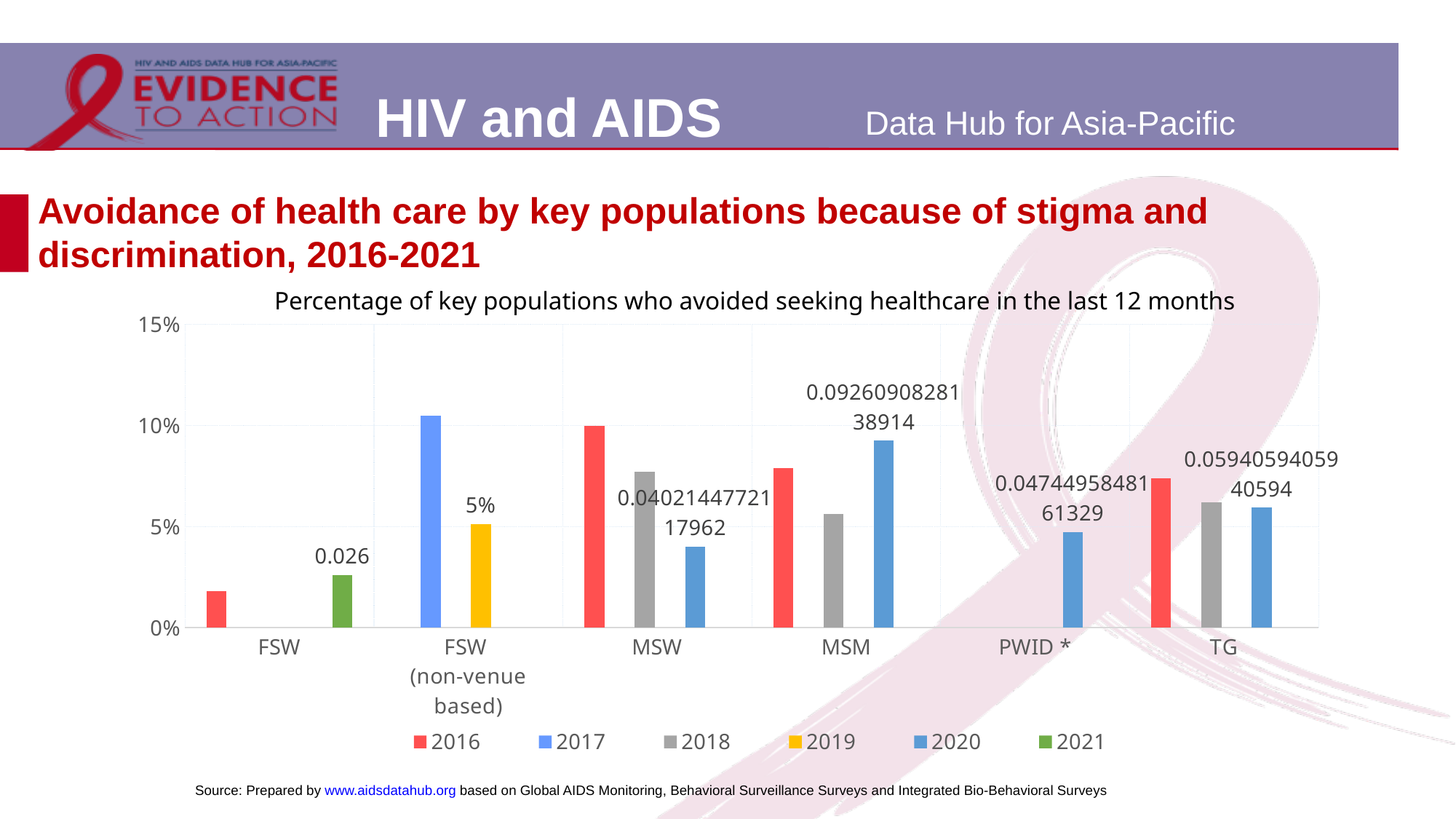
What is the data label on the 2020 bar for MSW? 0.0402144772117962 What is the data label on the 2020 bar for PWID *? 0.0474495848161329 How many series (years) does the legend list? 6 What kind of chart is shown on the slide? bar chart Is the 2018 value for MSW greater or less than 5%? greater For MSM, which is larger: the 2016 value or the 2020 value? 2020 What is the data label on the 2020 bar for MSM? 0.0926090828138914 What is the data label on the 2020 bar for TG? 0.0594059405940594 How many key population categories are shown on the x axis? 6 What is the data label on the 2021 bar for FSW? 0.026 For MSW, which year has the highest bar? 2016 What is the data label on the 2019 bar for FSW (non-venue based)? 5%